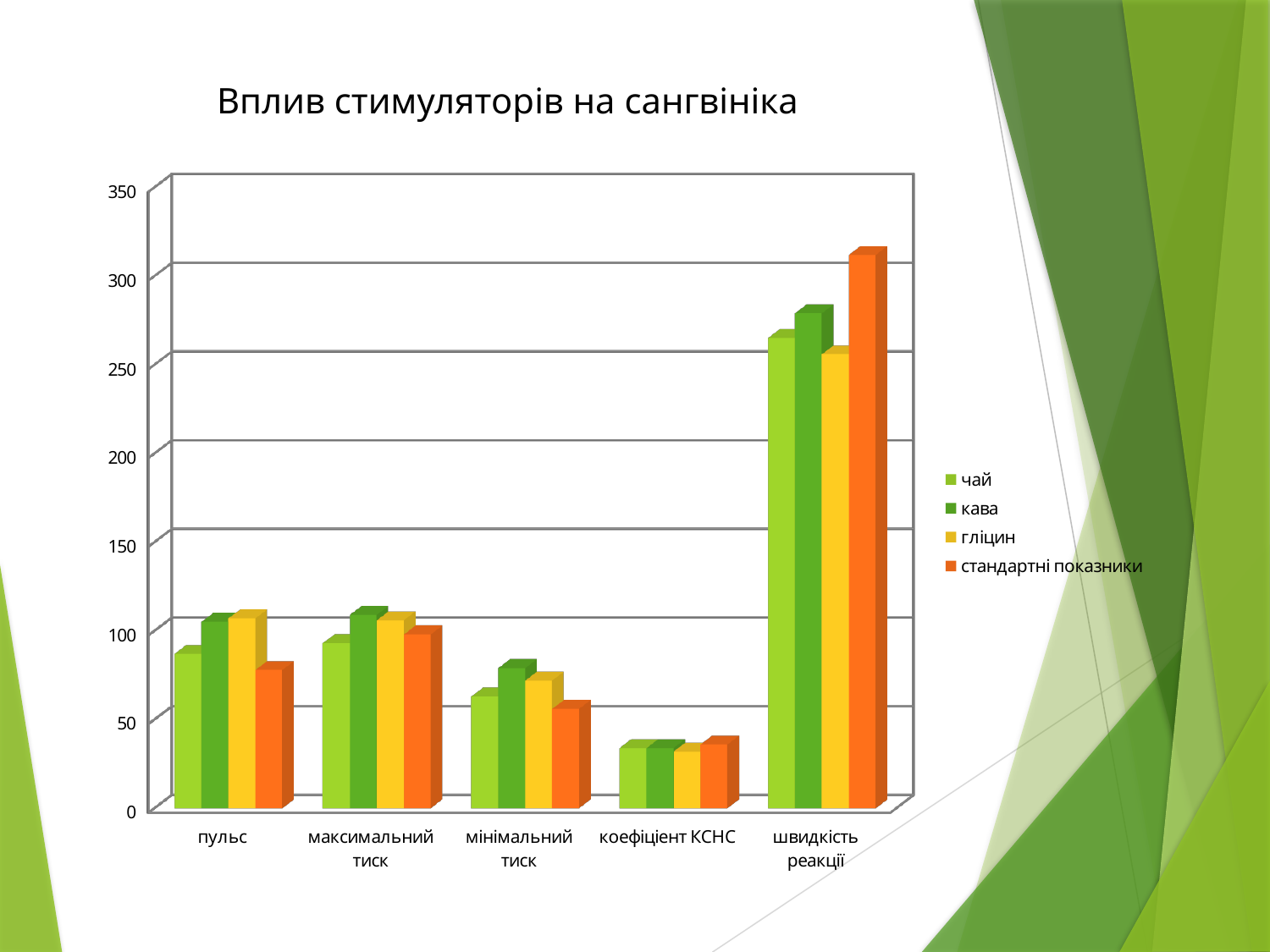
How many series does the legend list? 4 Which category has the highest values across all series? швидкість реакції What kind of chart is shown on the slide? bar chart Is the value for чай in пульс greater or less than 100? less In швидкість реакції, which series has the highest value? стандартні показники Which category has the lowest values across all series? коефіціент КСНС Is the value for стандартні показники in швидкість реакції greater or less than 300? greater Which series is shown in orange in the legend? стандартні показники In мінімальний тиск, which is larger: the value for кава or the value for стандартні показники? кава What is the title of the chart? Вплив стимуляторів на сангвініка How many categories are shown on the x axis? 5